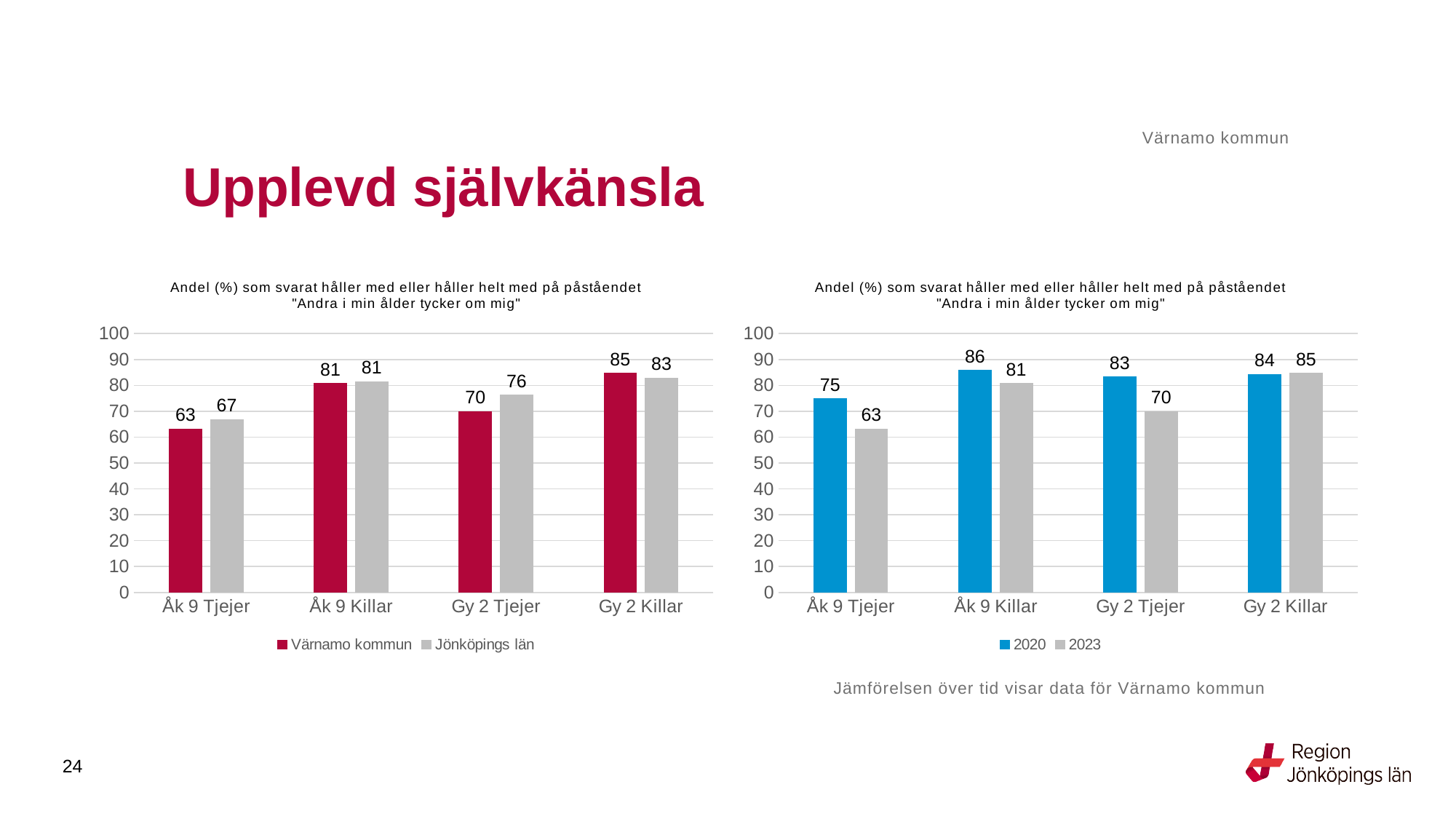
In the right chart, what is the value for 2020 for Åk 9 Killar? 86 In the right chart, what is the difference between 2020 and 2023 for Åk 9 Tjejer? 12 In the left chart, what is the value for Värnamo kommun for Åk 9 Tjejer? 63 In the right chart, how many categories are shown on the x axis? 4 In the right chart, what is the value for 2023 for Åk 9 Tjejer? 63 In the left chart, which category has the lowest value for Jönköpings län? Åk 9 Tjejer In the left chart, what is the difference between Jönköpings län and Värnamo kommun for Gy 2 Tjejer? 6 In the left chart, what is the value for Jönköpings län for Gy 2 Tjejer? 76 What kind of chart is the right chart? Bar chart In the left chart, how many series does the legend list? 2 In the left chart, which category has the highest value for Värnamo kommun? Gy 2 Killar In the right chart, which is larger for Gy 2 Tjejer, 2020 or 2023? 2020